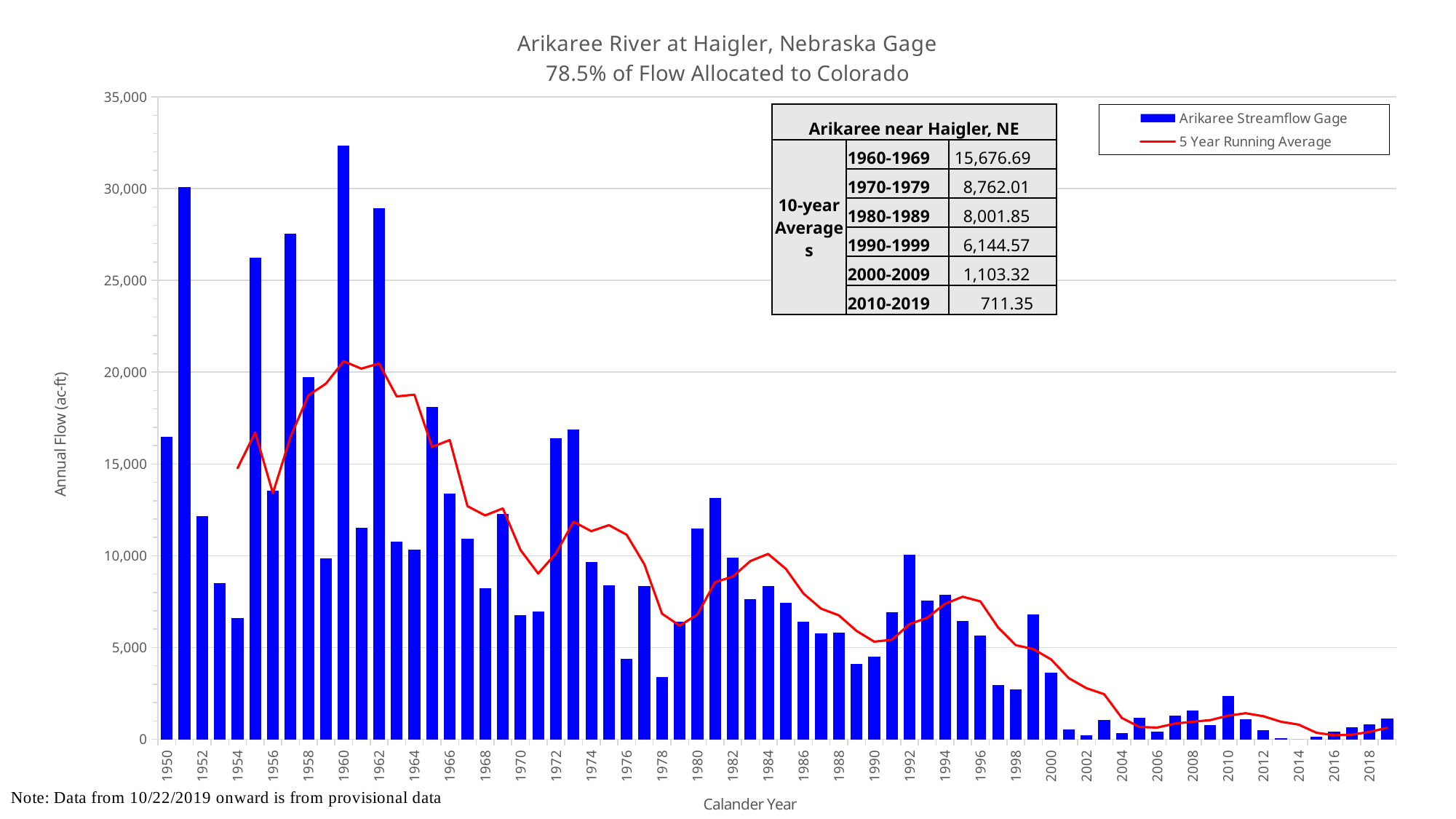
According to the 10-year averages table, what is the average for 2010-2019? 711.35 What kind of chart is used to show the Arikaree Streamflow Gage data? bar chart Is the annual flow value for 1981 greater or less than 10,000? greater Is the annual flow value for 1957 greater or less than 25,000? greater What is the label on the vertical axis? Annual Flow (ac-ft) Is the annual flow value for 1978 greater or less than 5,000? less Which year has the highest annual flow bar? 1960 How many series does the legend list? 2 Overall, do the annual flow values rise or fall from 1950 to 2019? fall According to the 10-year averages table, what is the average for 1960-1969? 15,676.69